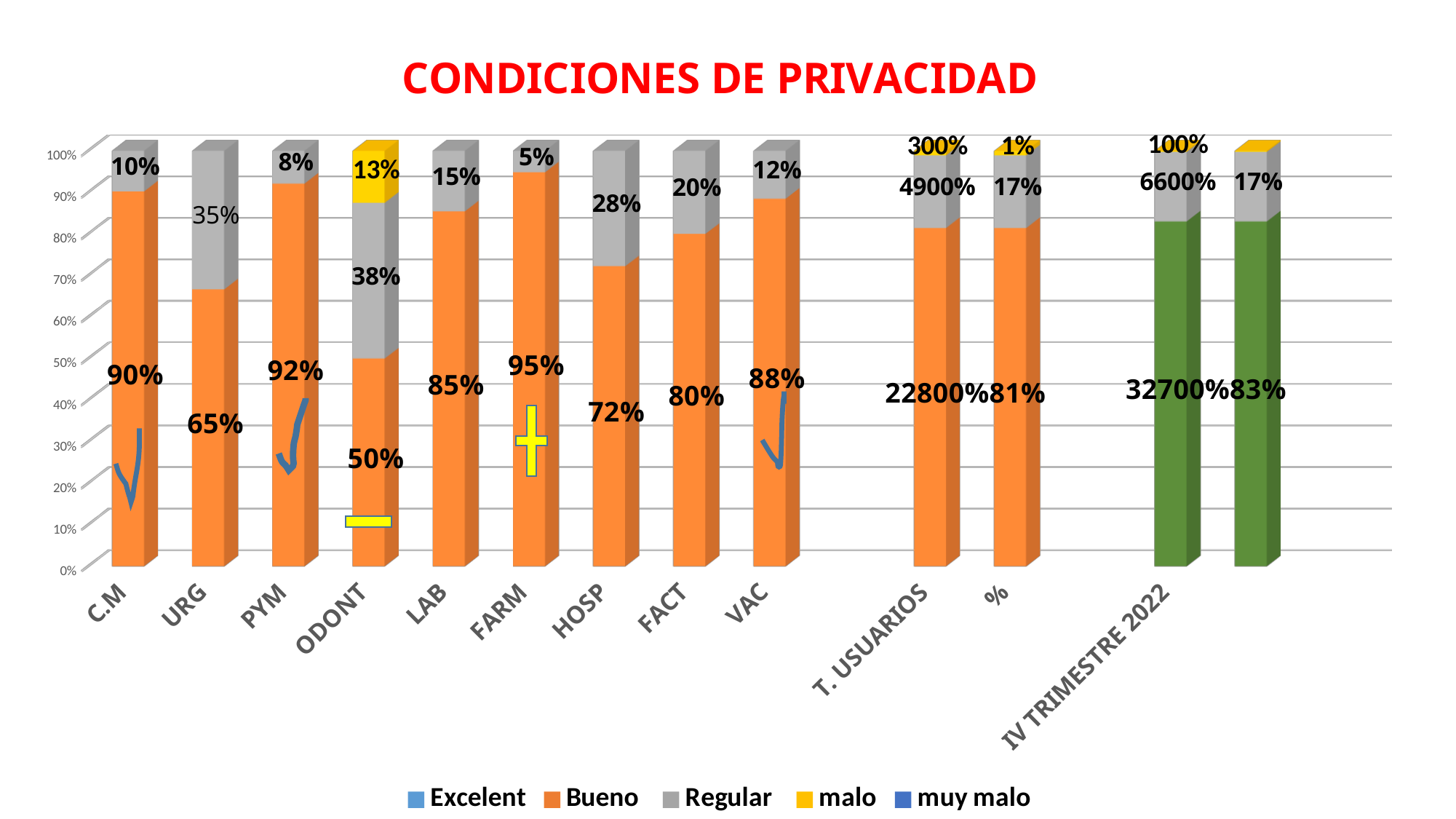
What is the Bueno value for C.M? 90% What is the Regular value for URG? 35% What is the Bueno value for HOSP? 72% Which legend entry is shown in yellow? malo What is the malo value for ODONT? 13% Among C.M, URG, PYM, ODONT, LAB, FARM, HOSP, FACT and VAC, which category has the lowest Bueno value? ODONT How many series does the legend list? 5 Which has a larger Regular value, HOSP or FACT? HOSP What type of chart is shown on the slide? stacked bar chart What is the difference between the Bueno values for PYM and LAB? 7% Among C.M, URG, PYM, ODONT, LAB, FARM, HOSP, FACT and VAC, which category has the highest Bueno value? FARM What is the title of the chart? CONDICIONES DE PRIVACIDAD